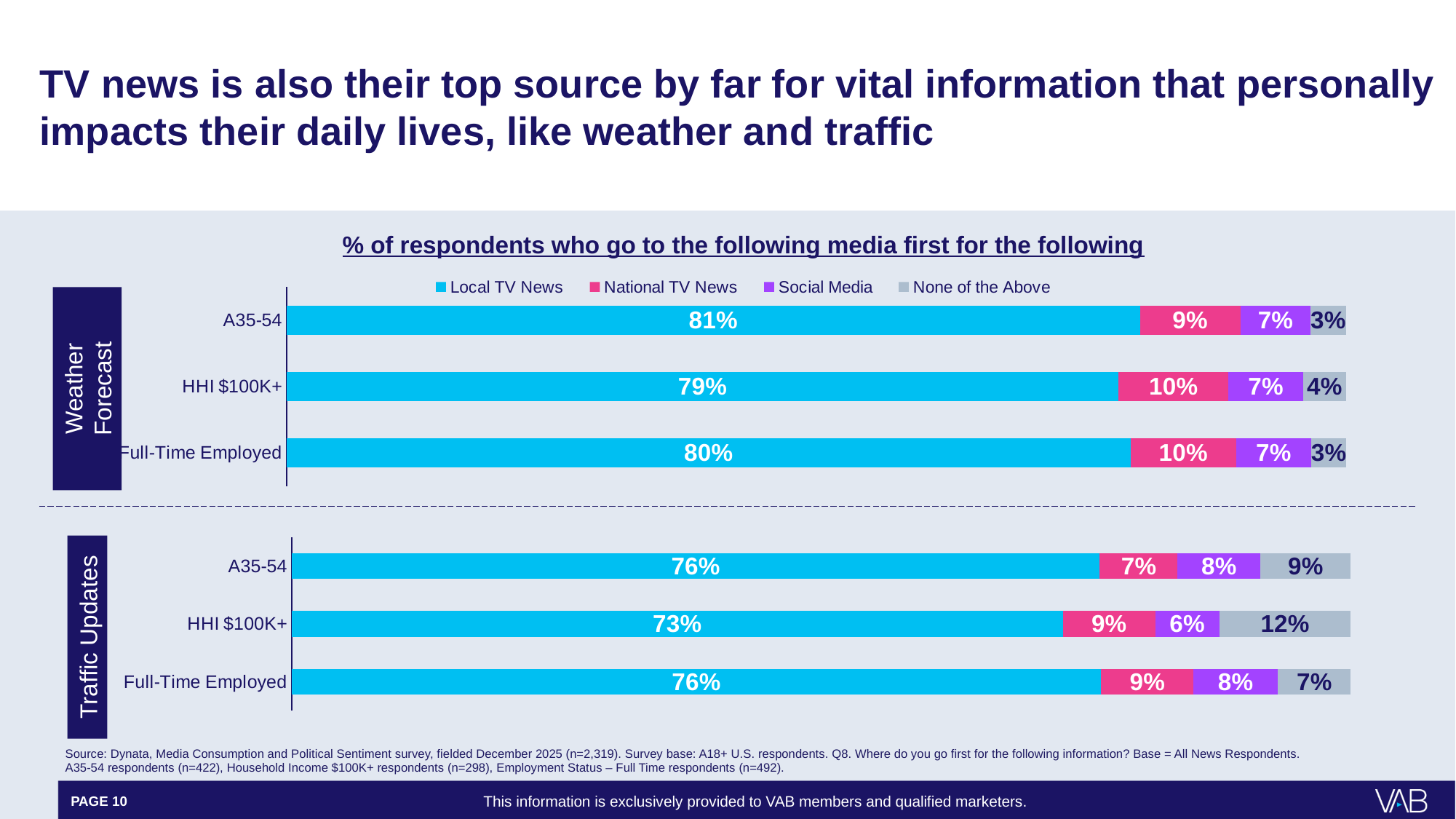
How many series does the legend list? 4 How many groups are shown in the Traffic Updates chart? 3 In the Traffic Updates chart, what is the difference between the Local TV News values for A35-54 and HHI $100K+? 3% What kind of chart is used for the Weather Forecast data? Stacked bar chart In the Weather Forecast chart, what percentage of A35-54 respondents go to Local TV News first? 81% In the Traffic Updates chart, which group has the lowest Local TV News value? HHI $100K+ In the Traffic Updates chart, what percentage of HHI $100K+ respondents go to Local TV News first? 73% In the Traffic Updates chart, what is the None of the Above value for HHI $100K+? 12% In the Weather Forecast chart, what is the National TV News value for Full-Time Employed? 10% In the Weather Forecast chart, which is larger for HHI $100K+: National TV News or Social Media? National TV News In the Weather Forecast chart, which group has the highest Local TV News value? A35-54 In the Traffic Updates chart, what is the total of the stacked bar for Full-Time Employed? 100%